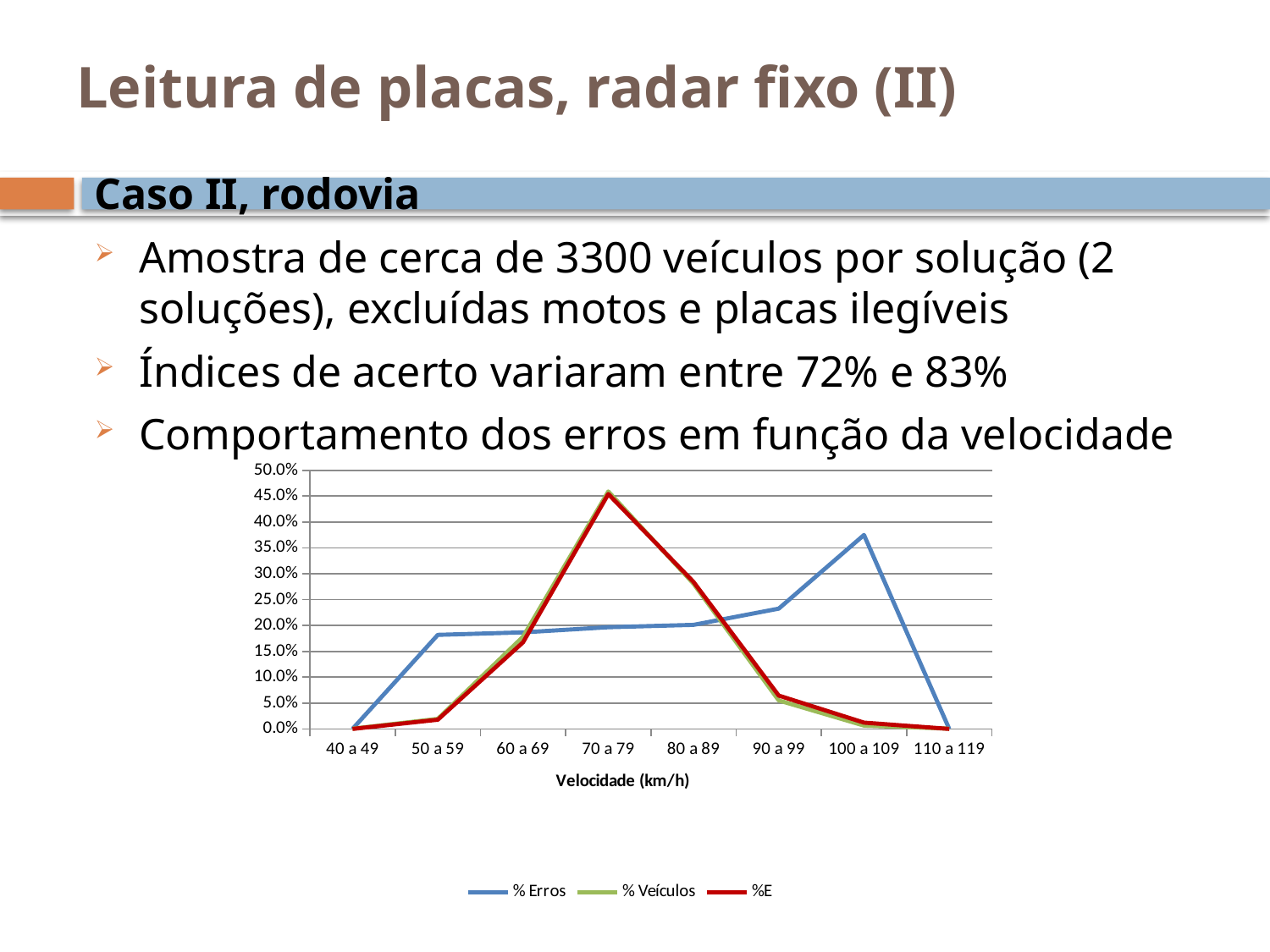
Is the value of %E for 70 a 79 greater or less than 40.0%? greater What kind of chart is shown on the slide? line chart Is the value of %E for 90 a 99 greater or less than 10.0%? less How many speed categories are shown on the x axis of the chart? 8 For the 70 a 79 category, which series has the larger value, % Erros or %E? %E Is the value of % Erros for 100 a 109 greater or less than 35.0%? greater How many series does the chart legend list? 3 For the 100 a 109 category, which series has the larger value, % Erros or %E? % Erros In which speed category does the %E series reach its highest value? 70 a 79 In which speed category does the % Erros series reach its highest value? 100 a 109 What is the title of the x axis of the chart? Velocidade (km/h)